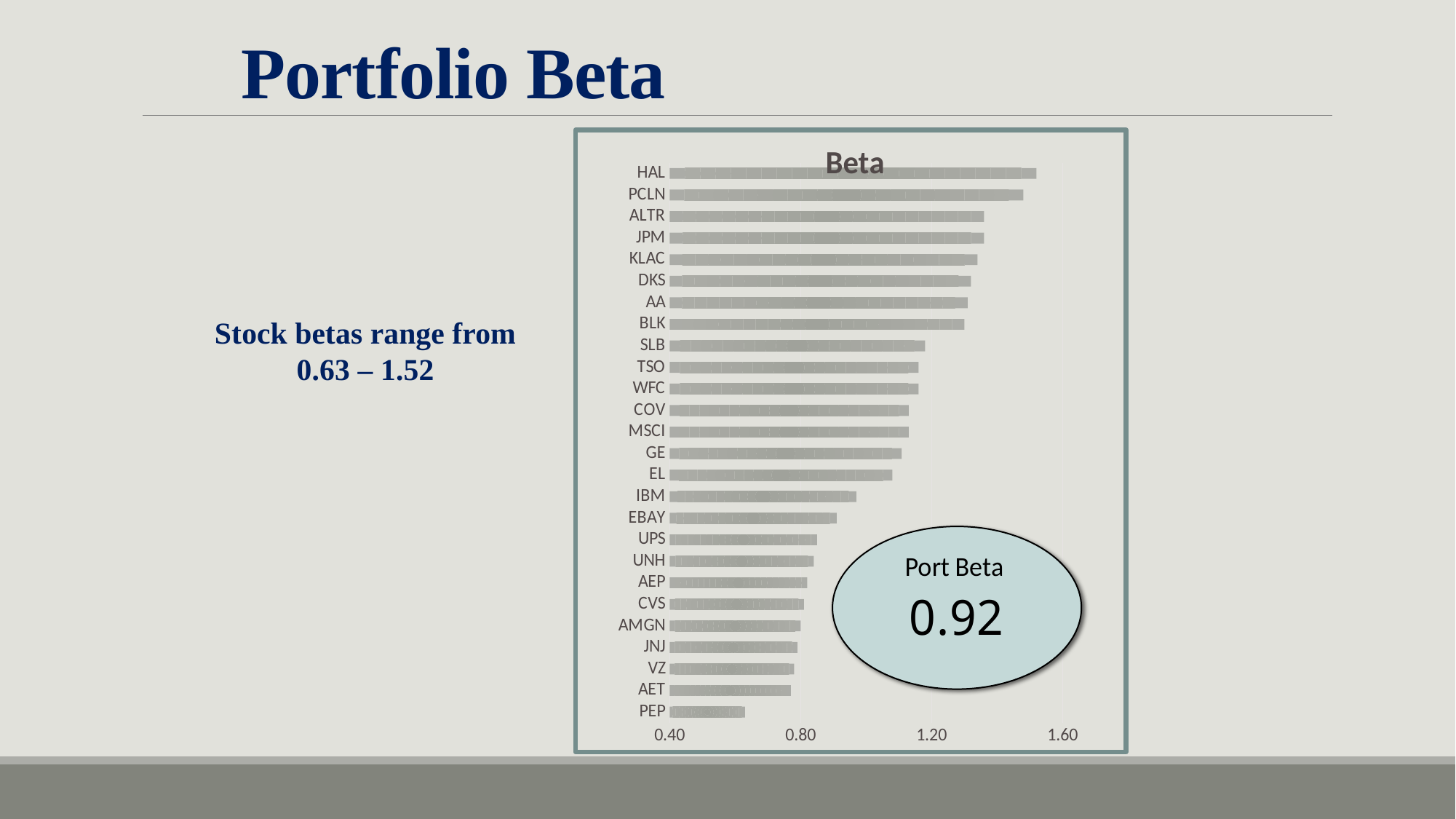
Is the value for PEP greater or less than 0.80? less Which stock has the lowest beta in the chart? PEP What kind of chart is shown on the slide? bar chart What is the title of the chart? Beta What Port Beta value is shown in the oval on the chart? 0.92 Is the value for GE greater or less than 1.20? less Is the value for IBM greater or less than 0.80? greater How many stocks are listed in the chart? 26 Do the bar values increase or decrease going from the top of the chart to the bottom? decrease Which stock has the highest beta in the chart? HAL Which has a larger beta, JPM or IBM? JPM